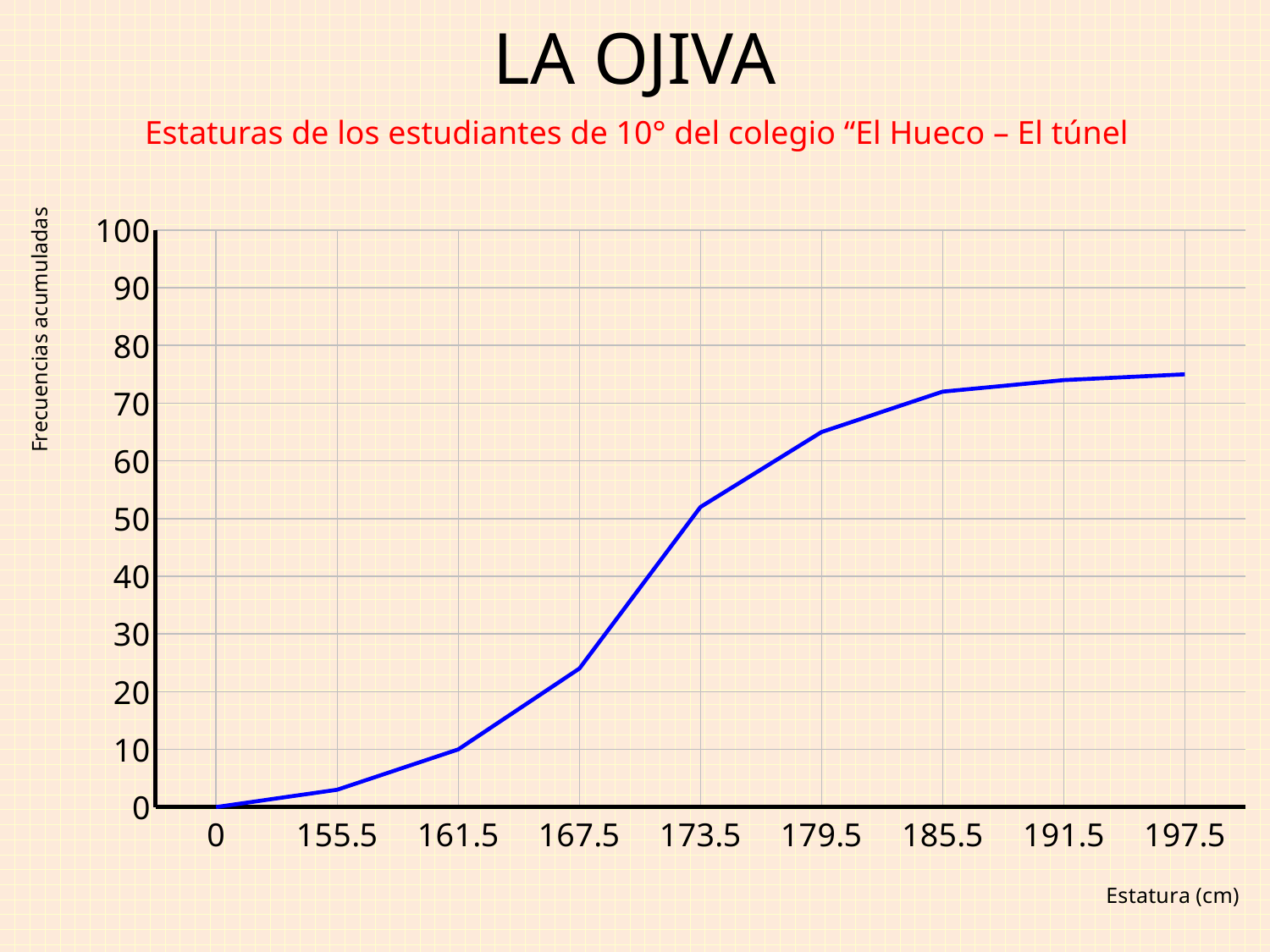
Do the cumulative frequencies rise or fall as height increases along the x axis? rise What is the cumulative frequency at a height of 161.5 cm? 10 What is the cumulative frequency at the x-axis value 0? 0 Is the cumulative frequency at 167.5 cm greater or less than 20? greater At which height is the cumulative frequency highest? 197.5 What is the label of the x axis? Estatura (cm) Is the cumulative frequency at 179.5 cm greater or less than 60? greater What kind of chart is shown on the slide? line chart How many points are plotted on the line? 9 Which has the larger cumulative frequency, 167.5 cm or 173.5 cm? 173.5 Is the cumulative frequency at 173.5 cm greater or less than 60? less